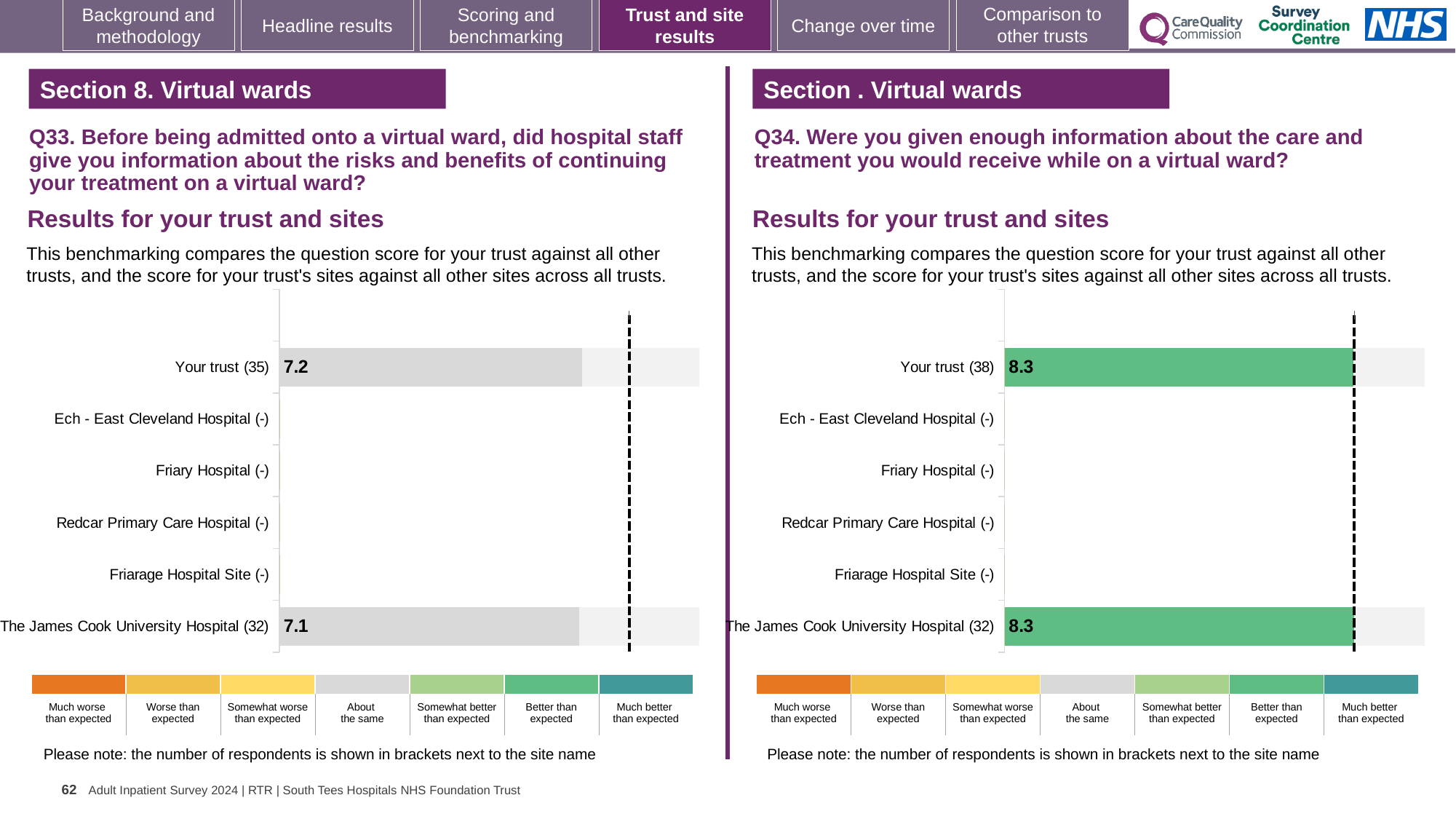
In the Q34 chart on the right, what is the score for The James Cook University Hospital (32)? 8.3 How many site/trust categories are listed on the y axis of the Q33 chart on the left? 6 In the Q34 chart on the right, what is the score for Your trust (38)? 8.3 In the Q33 chart on the left, which benchmark category does the grey colour of the bars correspond to in the legend? About the same In the Q33 chart on the left, what is the difference between the score for Your trust (35) and the score for The James Cook University Hospital (32)? 0.1 In the Q34 chart on the right, which benchmark category does the green colour of the bars correspond to in the legend? Better than expected In the Q33 chart on the left, what is the score for The James Cook University Hospital (32)? 7.1 In the Q34 chart on the right, what is the difference between the score for Your trust (38) and the score for The James Cook University Hospital (32)? 0 In the Q33 chart on the left, which has the higher score: Your trust (35) or The James Cook University Hospital (32)? Your trust (35) In the Q33 chart on the left, what is the score for Your trust (35)? 7.2 How many site/trust categories are listed on the y axis of the Q34 chart on the right? 6 What type of chart is used for the Q33 results on the left? Bar chart